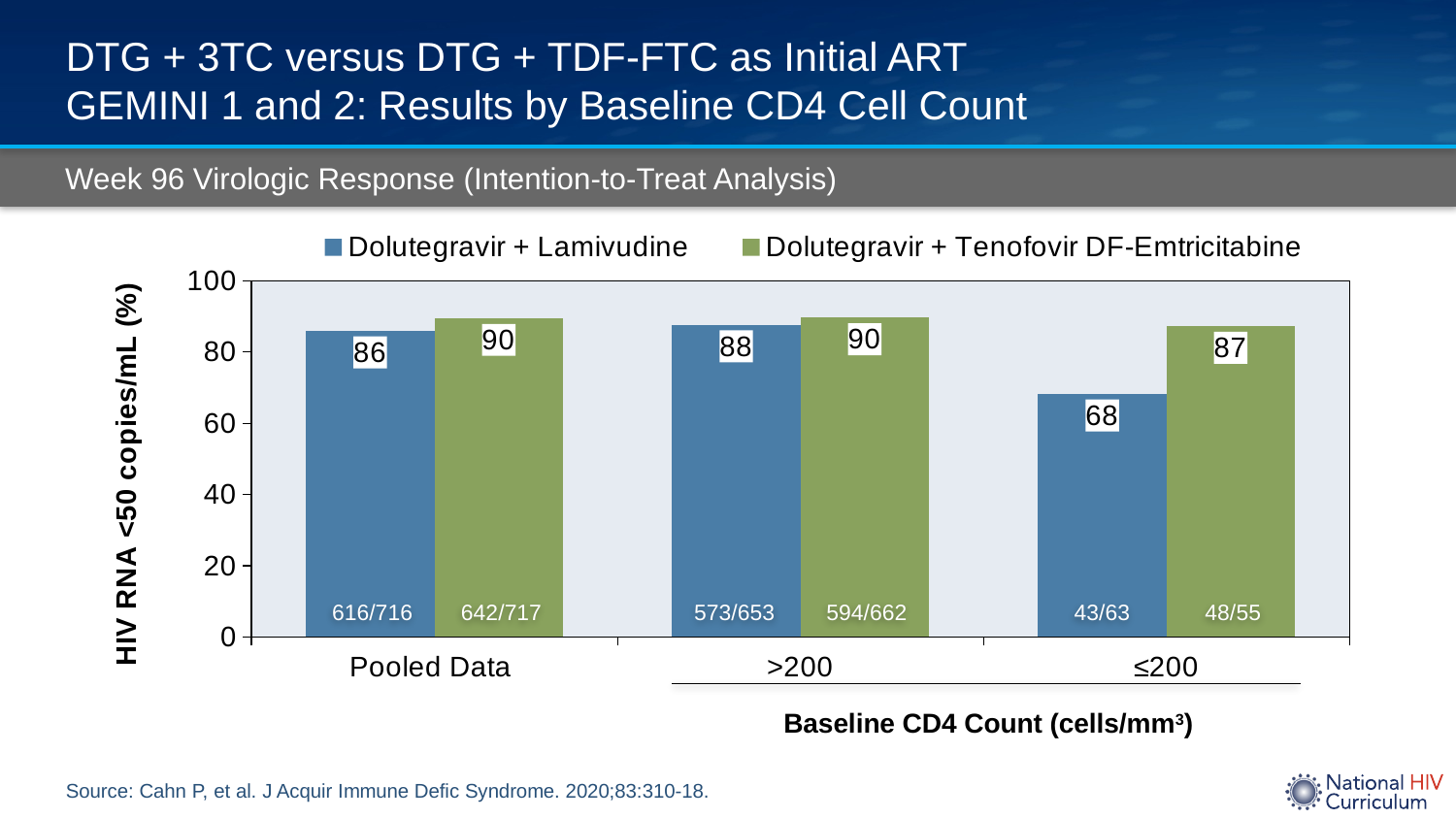
What is the value for Dolutegravir + Tenofovir DF-Emtricitabine in the ≤200 baseline CD4 count category? 87 What is the difference between the Dolutegravir + Tenofovir DF-Emtricitabine and Dolutegravir + Lamivudine values in the ≤200 category? 19 What is the label of the y axis? HIV RNA <50 copies/mL (%) What is the value for Dolutegravir + Lamivudine in the Pooled Data category? 86 What is the value for Dolutegravir + Lamivudine in the >200 baseline CD4 count category? 88 How many baseline CD4 count categories are shown on the x axis? 3 How many series does the legend list? 2 What fraction is printed on the Dolutegravir + Lamivudine bar for the ≤200 category? 43/63 In the >200 category, which series has the larger value? Dolutegravir + Tenofovir DF-Emtricitabine Which category has the lowest value for Dolutegravir + Lamivudine? ≤200 What is the difference between the two series' values in the Pooled Data category? 4 What kind of chart is shown on the slide? Bar chart